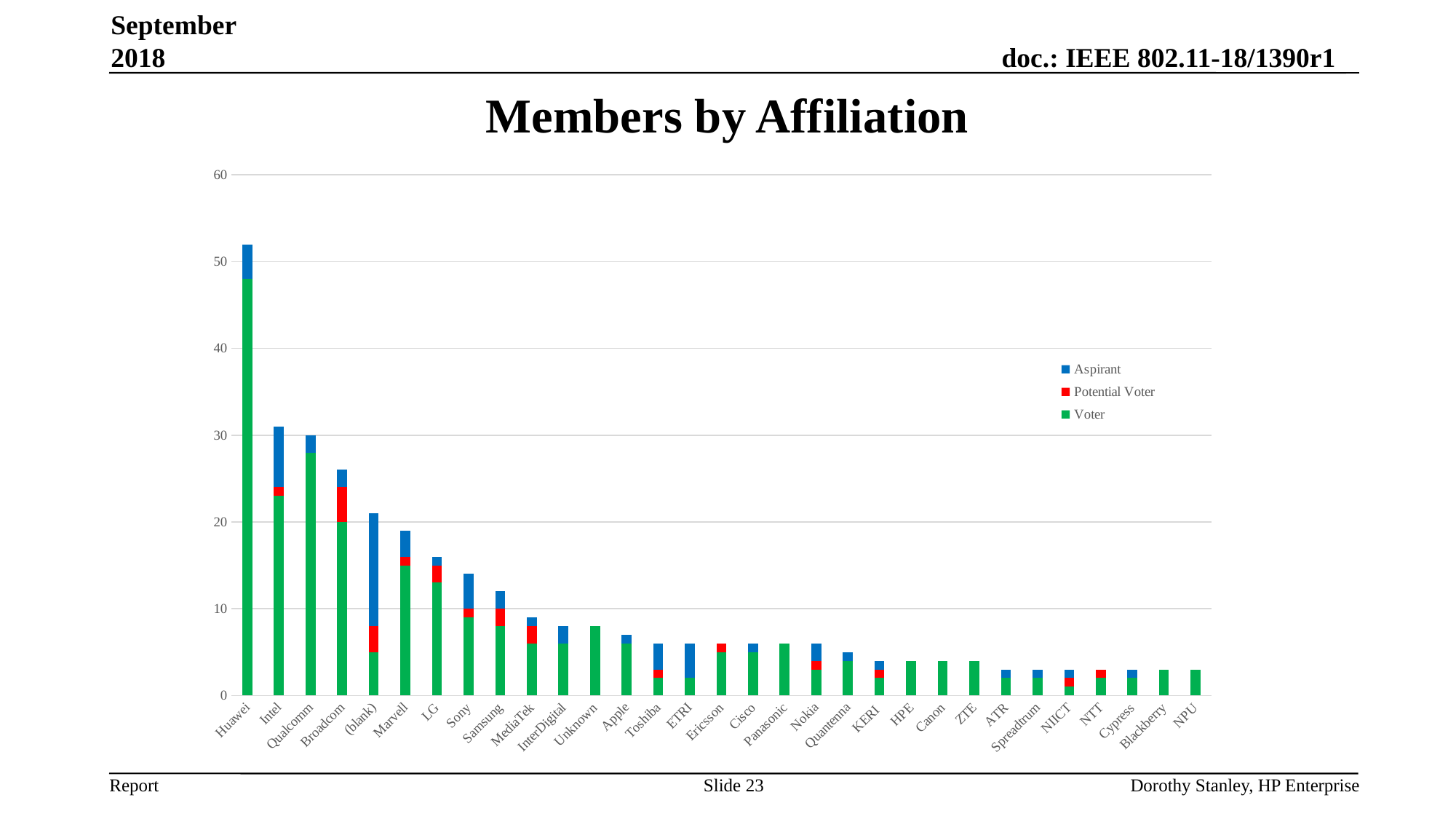
What is the title of the chart? Members by Affiliation Which has a larger total, Huawei or Intel? Huawei Which colour represents the Voter series in the legend? Green Is the total value for Sony greater or less than 10? greater Is the total value for Apple greater or less than 10? less Is the total value for Broadcom greater or less than 20? greater Do the total bar heights generally rise or fall moving from left to right along the x axis? Fall What kind of chart is shown on the slide? Stacked bar chart How many series does the legend list? 3 Which affiliation has the highest total number of members? Huawei Which has a larger total, Sony or Apple? Sony